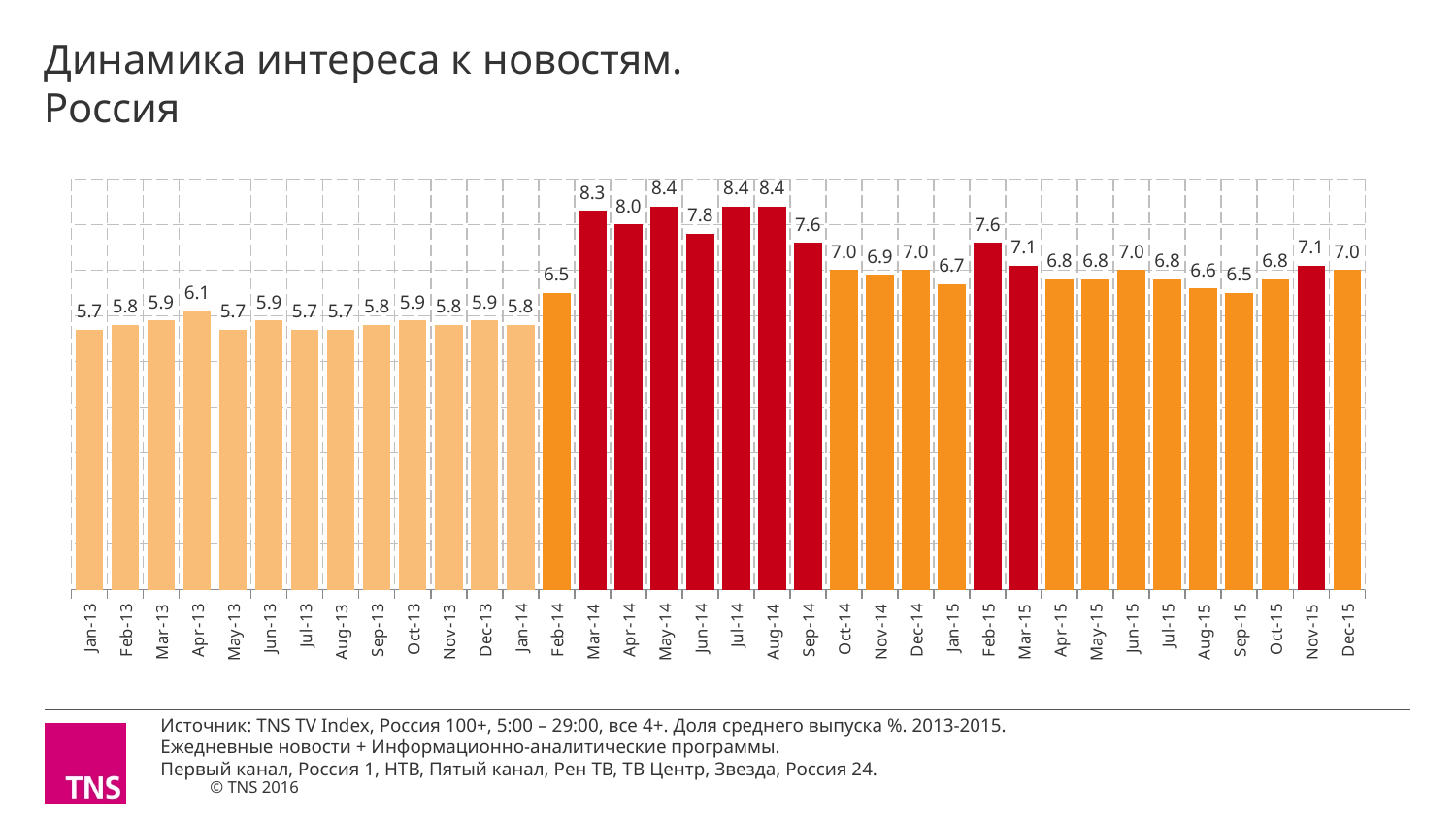
What is the value for Apr-14? 8.0 What is the title of the chart? Динамика интереса к новостям. Россия What is the difference between the values for Mar-14 and Feb-14? 1.8 What is the value for Jan-13? 5.7 What is the value for Dec-15? 7.0 Which is larger, the value for Jun-14 or the value for Sep-14? Jun-14 What kind of chart is shown on the slide? Bar chart What is the value for Feb-15? 7.6 What is the highest value shown on the chart? 8.4 Do the values rise or fall from Jan-14 to Mar-14? Rise What is the lowest value shown on the chart? 5.7 How many bars (months) are plotted on the chart? 36